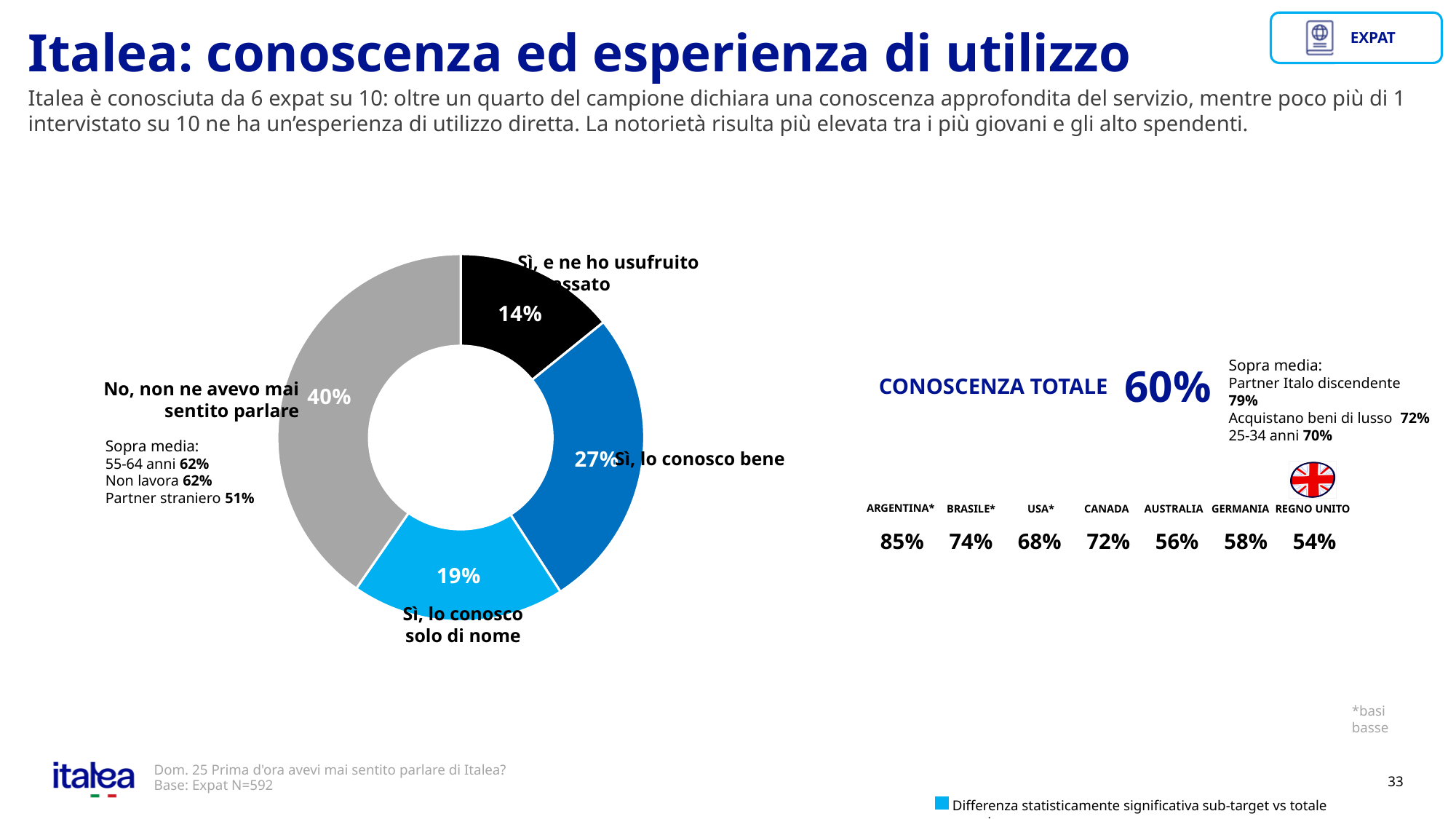
Which is larger: the share for "Sì, lo conosco bene" or for "Sì, lo conosco solo di nome"? Sì, lo conosco bene What colour is the slice for "No, non ne avevo mai sentito parlare"? grey Which response has the largest share of the pie? No, non ne avevo mai sentito parlare What is the difference in percentage points between "No, non ne avevo mai sentito parlare" and "Sì, lo conosco bene"? 13 percentage points What percentage is shown for the black slice ("Sì, e ne ho usufruito in passato")? 14% What percentage of respondents answered "No, non ne avevo mai sentito parlare"? 40% What percentage of respondents answered "Sì, lo conosco bene"? 27% What is the combined share of the three "Sì" slices (14%, 27% and 19%)? 60% What percentage of respondents answered "Sì, lo conosco solo di nome"? 19% How many slices does the pie chart have? 4 What kind of chart is shown on the slide? pie chart (donut) Which response has the smallest share of the pie? Sì, e ne ho usufruito in passato